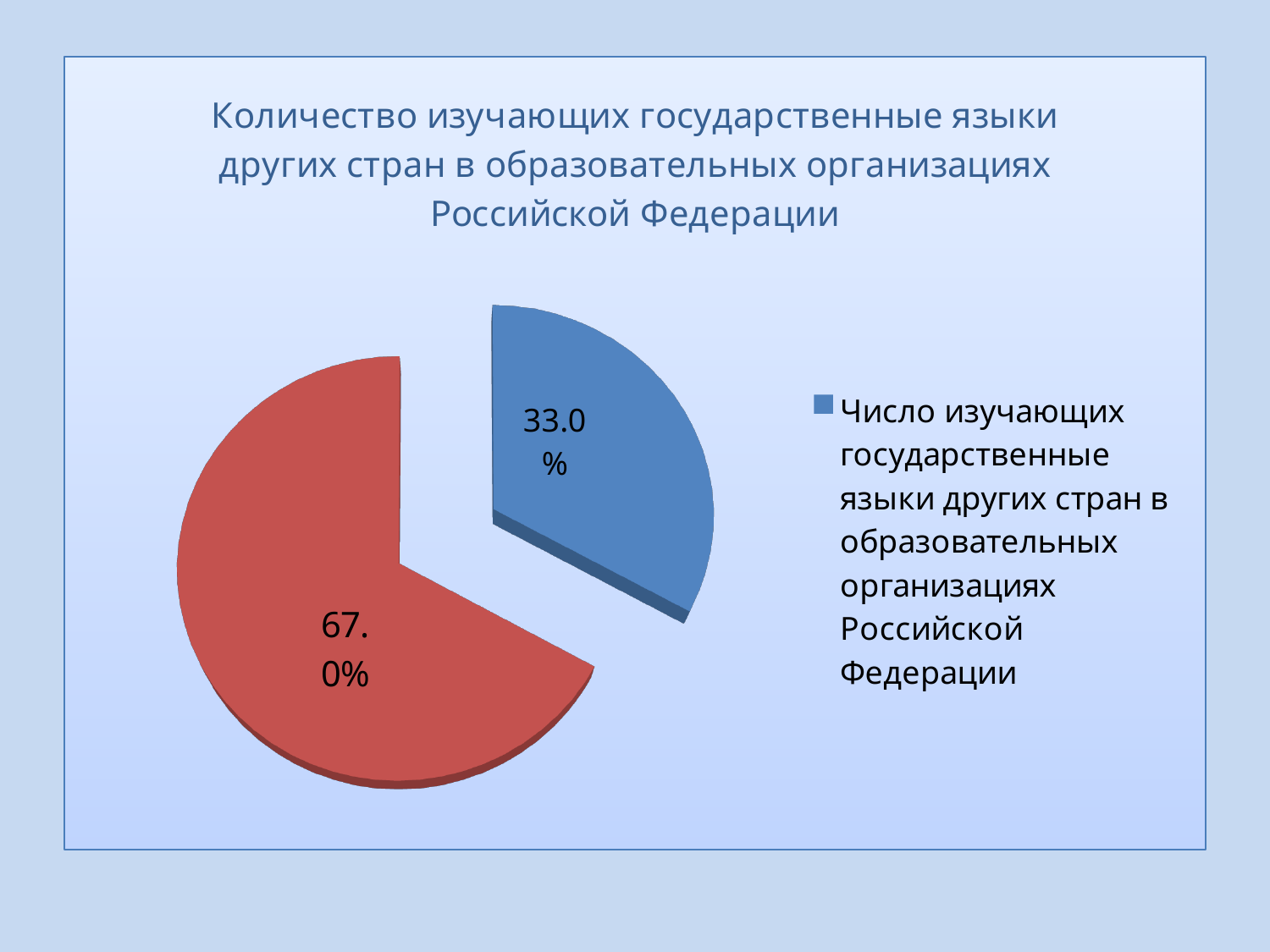
What share of the pie does the blue slice represent? 33.0% How many entries does the legend of the pie chart list? 1 What is the difference between the red slice and the blue slice of the pie chart? 34.0% What percentage is shown on the red slice of the pie chart? 67.0% Which is larger, the blue slice or the red slice? the red slice What percentage is shown on the blue slice of the pie chart? 33.0% What is the title of the chart? Количество изучающих государственные языки других стран в образовательных организациях Российской Федерации Which slice of the pie chart is the largest? the red slice (67.0%) What kind of chart is shown on the slide? pie chart How many slices does the pie chart have? 2 What is the value of the slice labelled 'Число изучающих государственные языки других стран в образовательных организациях Российской Федерации'? 33.0% Which slice of the pie chart is the smallest? the blue slice (33.0%)